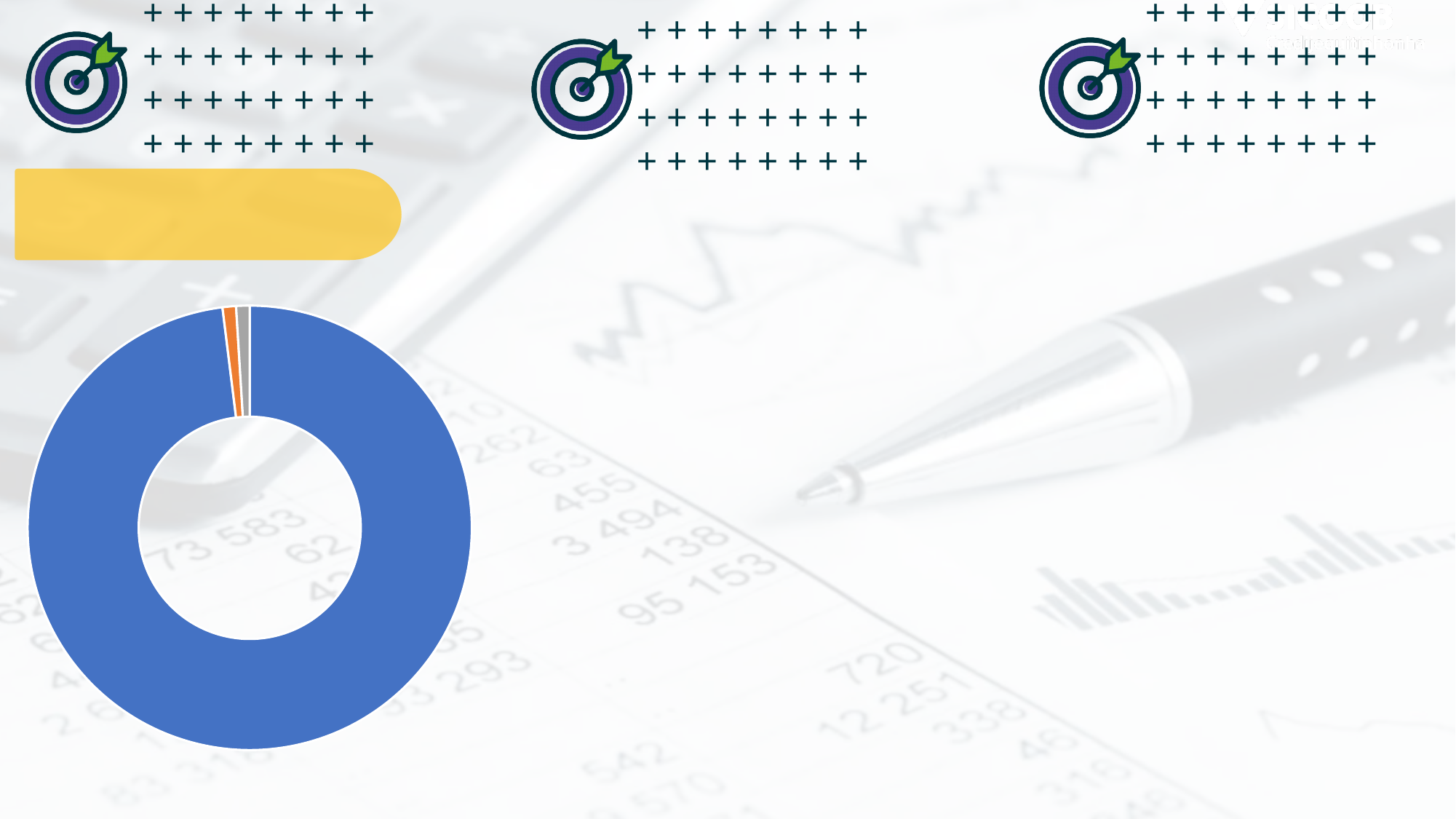
Which slice of the doughnut chart is the largest? the blue slice How many slices does the doughnut chart have? 3 Does the doughnut chart display a legend? No What kind of chart is shown on the slide? doughnut chart Which is larger in the doughnut chart, the blue slice or the orange slice? the blue slice Does the doughnut chart show data labels on its slices? No Does the blue slice account for more or less than half of the doughnut chart? more